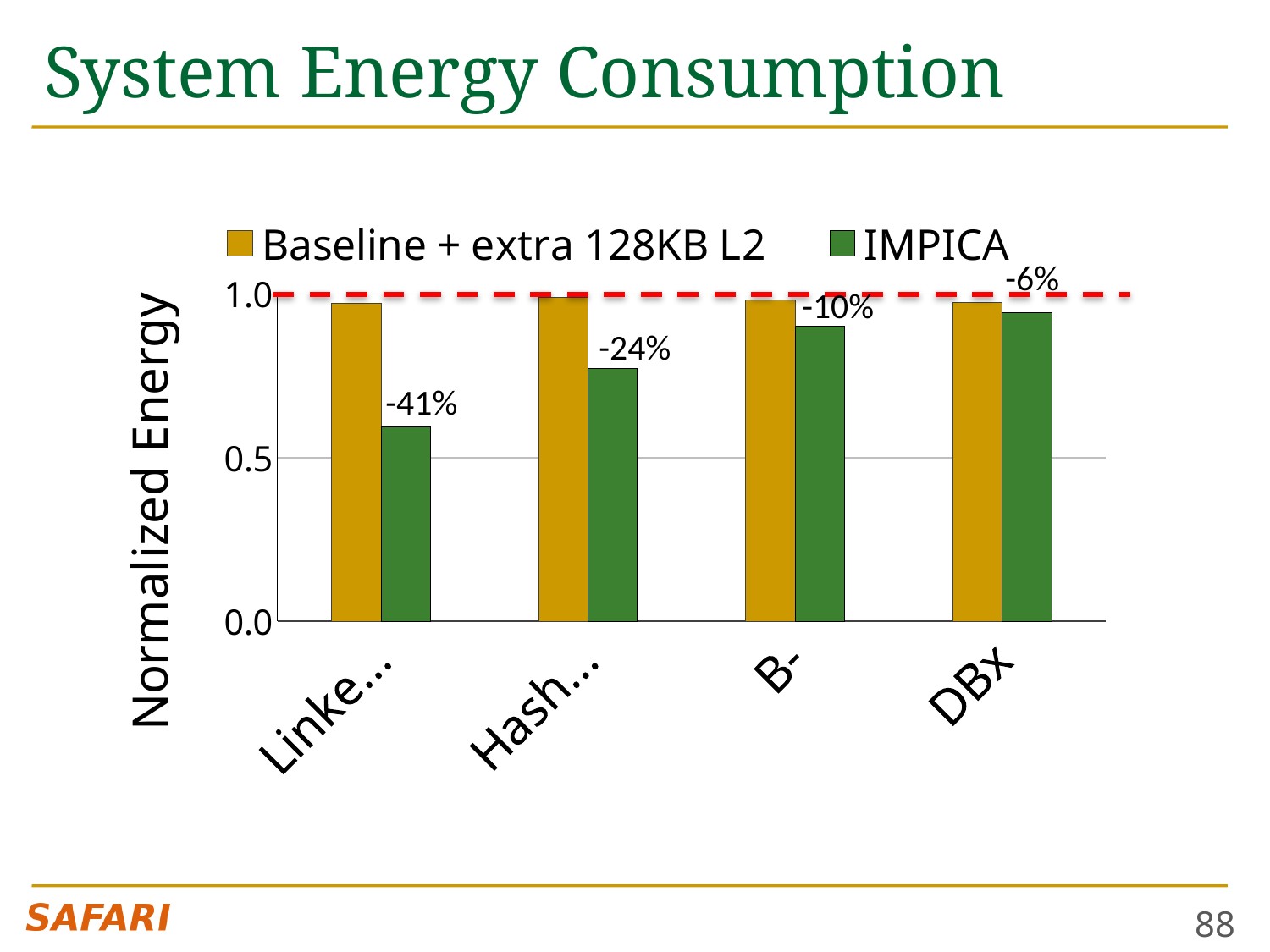
For B-, which series has the larger value, Baseline + extra 128KB L2 or IMPICA? Baseline + extra 128KB L2 What percentage label is printed above the IMPICA bar for B-? -10% What is the title of the y axis? Normalized Energy What is the smallest percentage reduction labeled on the chart? -6% How many series does the legend list? 2 Which series has the lower value in every category? IMPICA What are the two series named in the legend? Baseline + extra 128KB L2 and IMPICA Is the IMPICA value for DBx greater or less than 0.5? greater What percentage label is printed above the IMPICA bar for DBx? -6% What kind of chart is shown on the slide? bar chart What is the largest percentage reduction labeled on the chart? -41% How many categories are shown along the x axis? 4